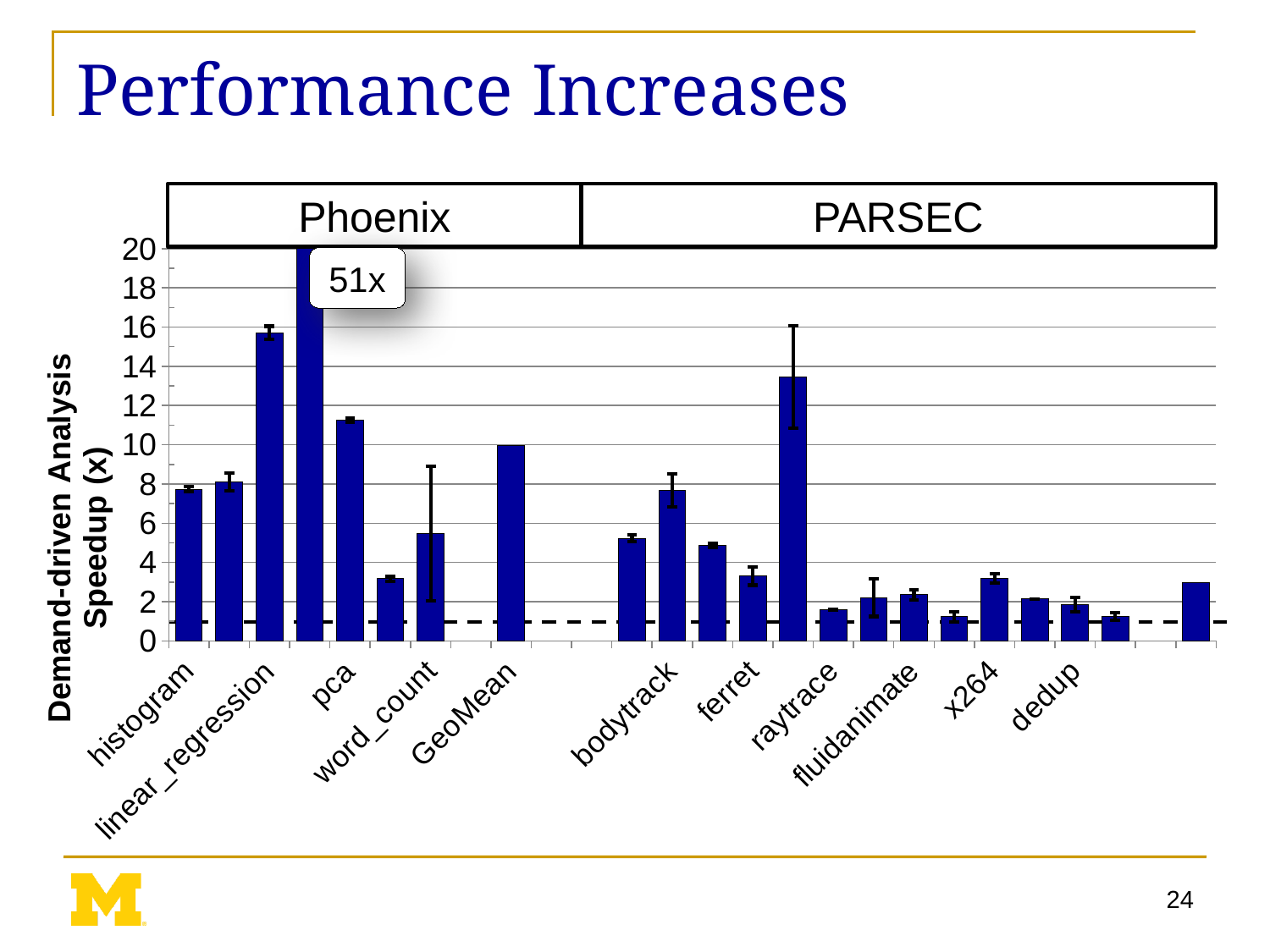
Which benchmark group, Phoenix or PARSEC, contains the tallest bar? Phoenix What is the title of the vertical axis of the chart? Demand-driven Analysis Speedup (x) Is the value for GeoMean greater or less than 8? greater What are the two benchmark group labels shown above the chart? Phoenix and PARSEC Is the value for histogram greater or less than 6? greater What value is annotated on the tallest bar in the chart? 51x Is the value for bodytrack greater or less than 4? greater What is the highest tick value shown on the vertical axis? 20 What kind of chart is shown on the slide? bar chart